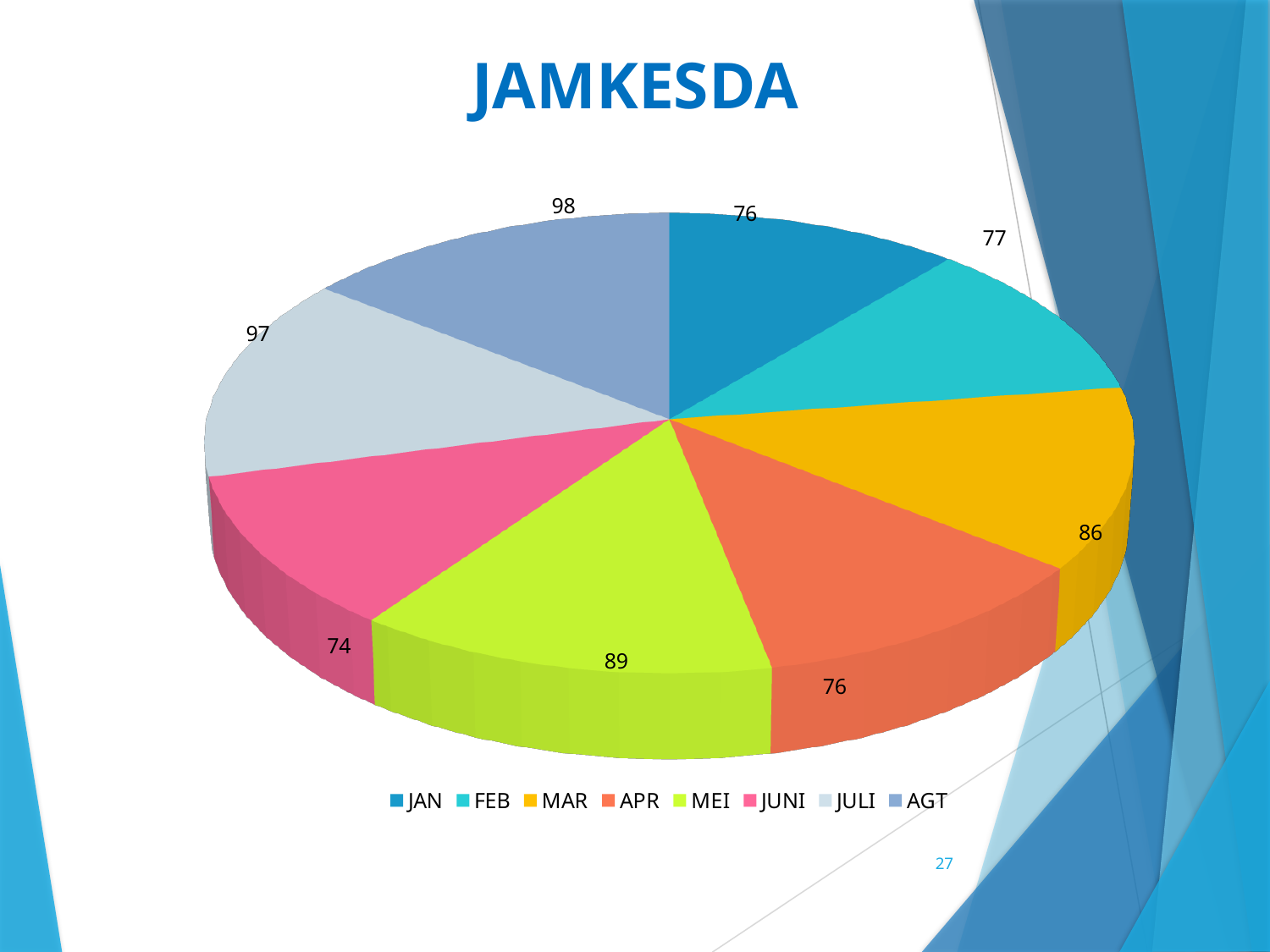
Which month has the highest value? AGT What is the value for MAR? 86 Which legend entry is shown in yellow-green? MEI Which is larger, the value for MAR or the value for FEB? MAR What is the title of the chart? JAMKESDA What is the value for AGT? 98 Which month has the lowest value? JUNI How many slices does the pie chart have? 8 What type of chart is shown on the slide? pie chart What is the difference between the values for AGT and JUNI? 24 What is the value for MEI? 89 What is the value for JUNI? 74